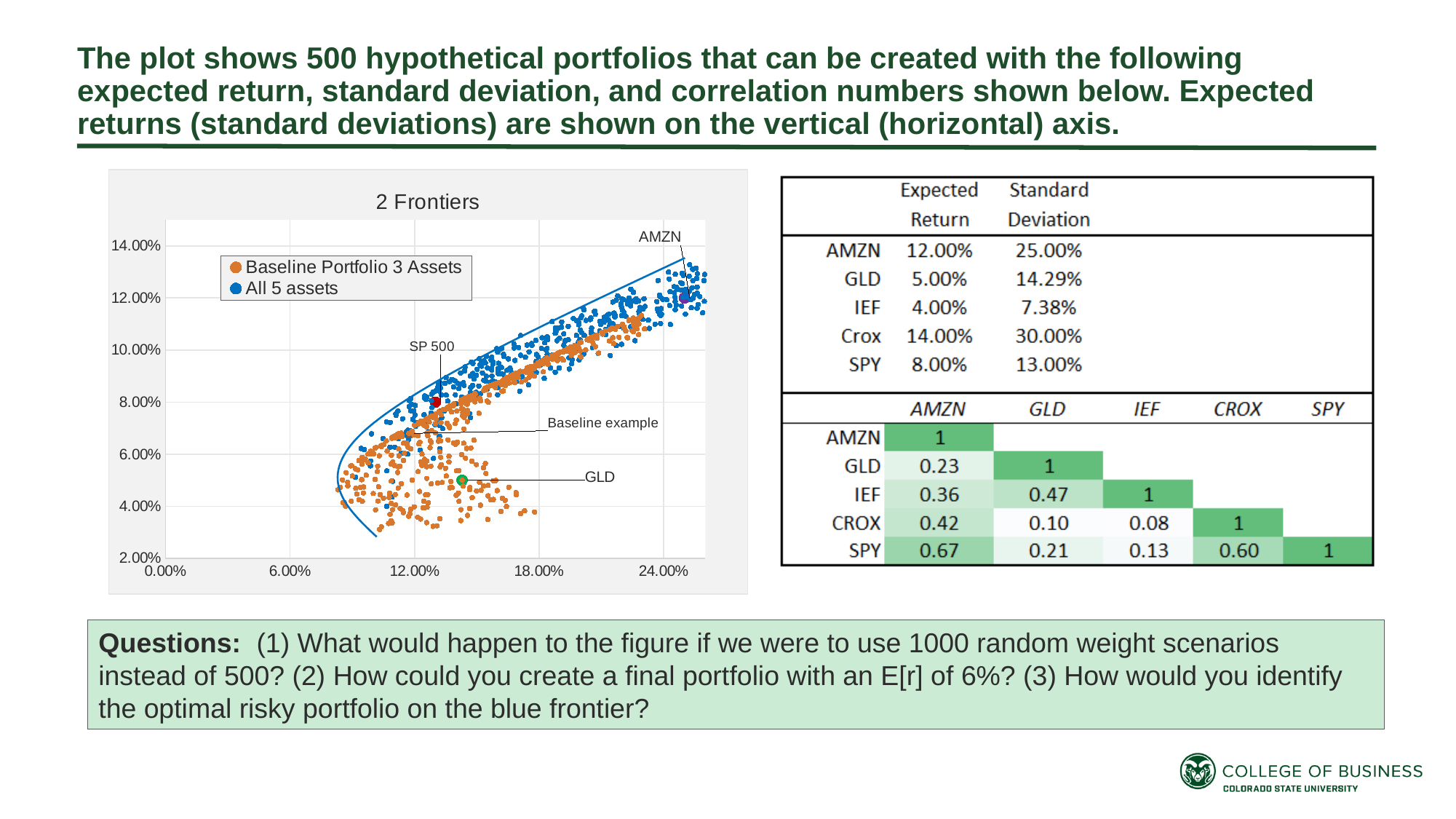
Is the expected return of the point labeled AMZN greater or less than 10.00%? greater How many series does the chart legend list? 2 Is the expected return of the point labeled GLD greater or less than 6.00%? less Of the labeled points on the chart, which has the lowest expected return? GLD What is the title of the chart? 2 Frontiers Is the standard deviation of the point labeled AMZN greater or less than 18.00%? greater Which labeled point has a higher expected return, AMZN or GLD? AMZN Along the upper blue frontier, does expected return rise or fall as standard deviation increases? rise What kind of chart is shown on the slide? Scatter chart Of the labeled points on the chart, which has the highest expected return? AMZN Which series in the chart is plotted in orange? Baseline Portfolio 3 Assets